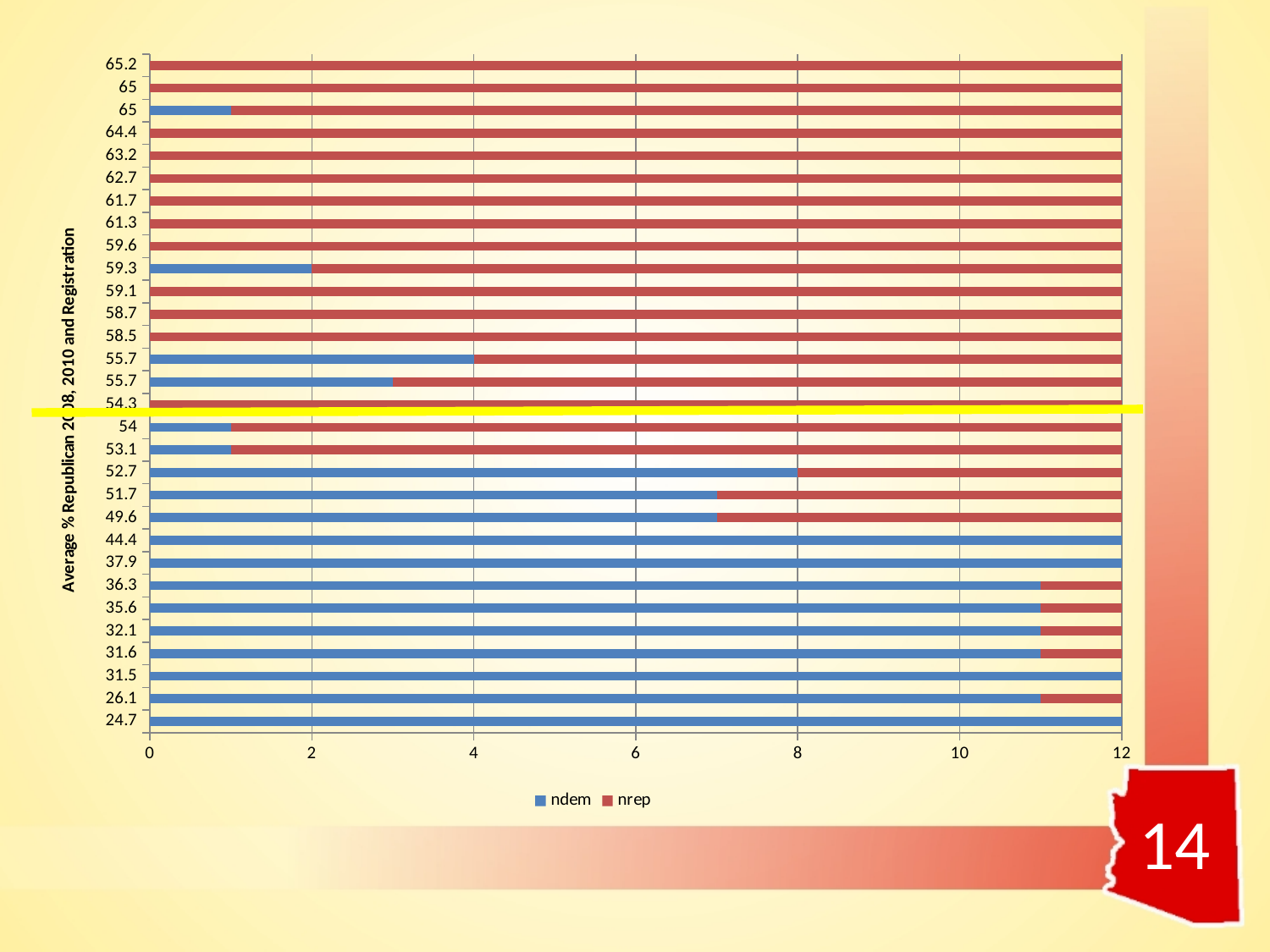
Is the nrep value for the category labelled 36.3 greater or less than 2? less What is the nrep value for the category labelled 65.2? 12 What is the ndem value for the category labelled 52.7? 8 Which colour represents the ndem series? blue Is the ndem value for the category labelled 51.7 greater or less than 6? greater Which has the larger ndem value: the category labelled 52.7 or the category labelled 59.3? 52.7 What is the ndem value for the category labelled 59.3? 2 How many series does the legend list? 2 What are the two series named in the legend? ndem and nrep How many categories are plotted on the vertical axis? 30 What kind of chart is shown on the slide? bar chart What is the ndem value for the category labelled 44.4? 12